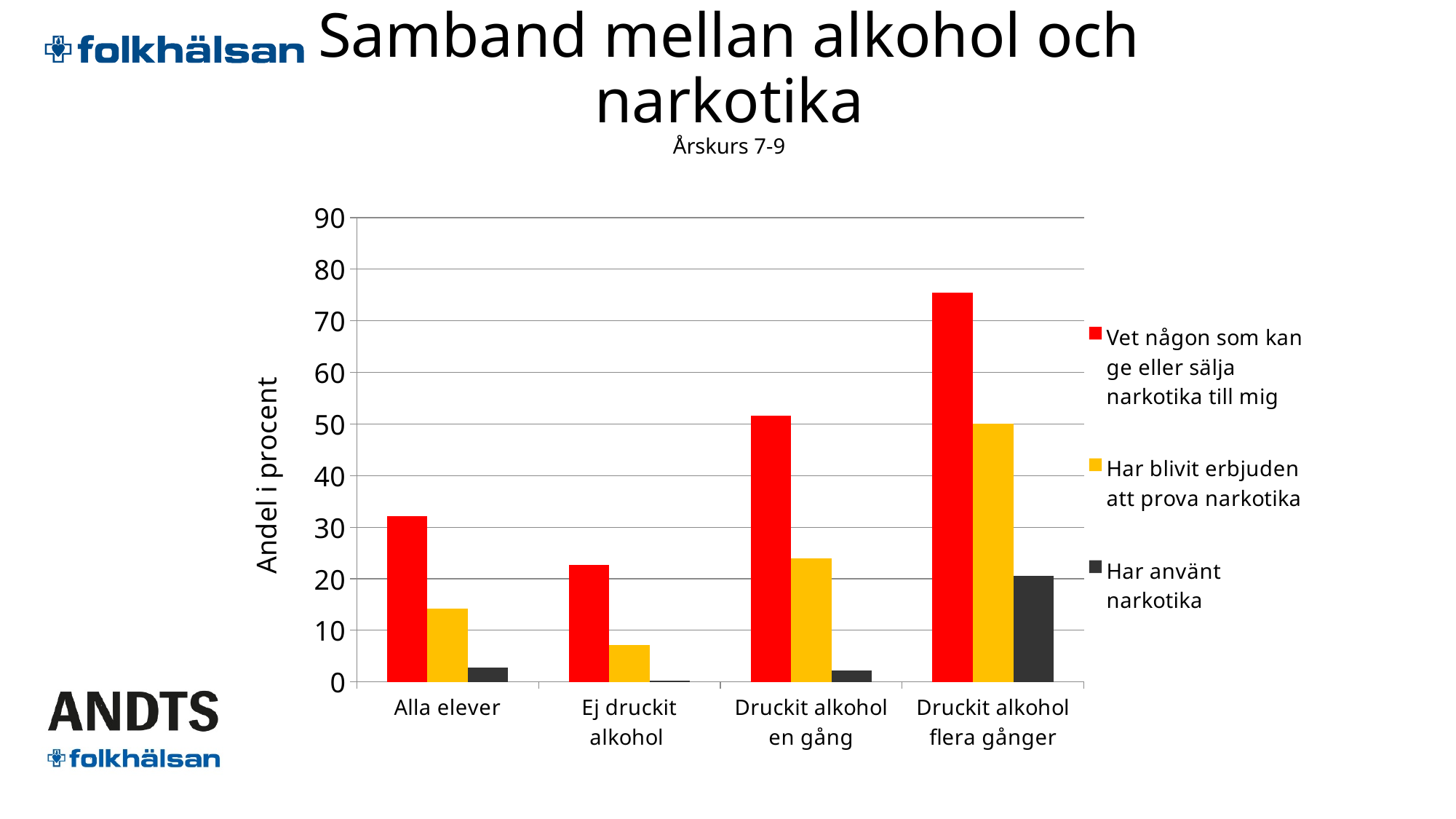
Is the value for 'Har använt narkotika' in the 'Druckit alkohol flera gånger' category greater or less than 10? greater Is the value for 'Vet någon som kan ge eller sälja narkotika till mig' in the 'Druckit alkohol flera gånger' category greater or less than 70? greater Which colour represents 'Har använt narkotika' in the chart? dark grey Which category has the highest value for 'Vet någon som kan ge eller sälja narkotika till mig'? Druckit alkohol flera gånger What is the label of the y axis of the chart? Andel i procent How many series does the legend list? 3 Which category has the lowest value for 'Har använt narkotika'? Ej druckit alkohol How many categories are shown on the x axis of the chart? 4 Which is larger: 'Har blivit erbjuden att prova narkotika' for 'Druckit alkohol en gång' or for 'Ej druckit alkohol'? Druckit alkohol en gång What kind of chart is shown on the slide? bar chart Is the value for 'Har blivit erbjuden att prova narkotika' in the 'Alla elever' category greater or less than 20? less Does the value for 'Vet någon som kan ge eller sälja narkotika till mig' rise or fall from 'Ej druckit alkohol' to 'Druckit alkohol flera gånger'? rise